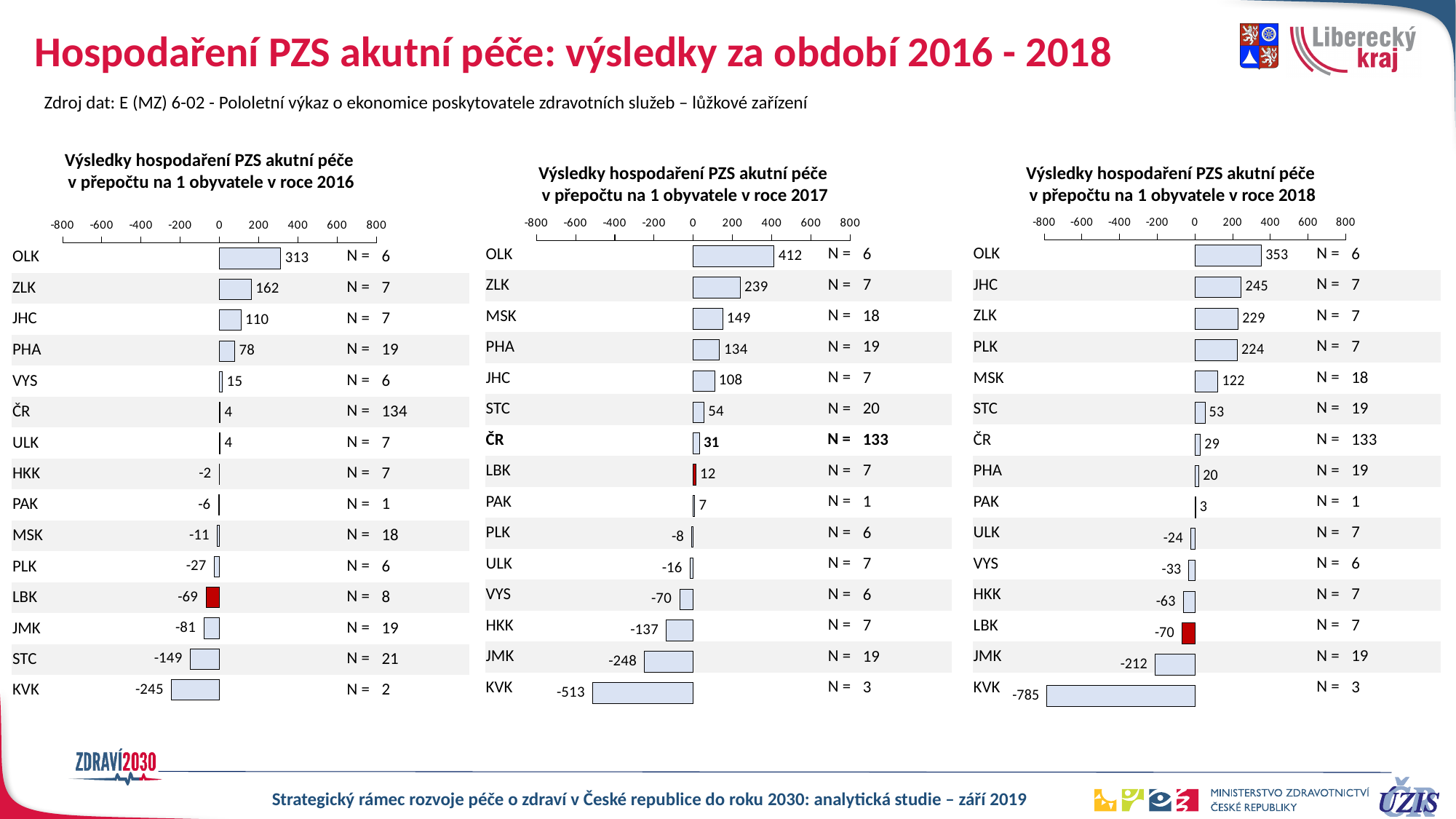
In the 2017 chart, which region has the lowest value? KVK In the 2017 chart, which is larger, the value for MSK or the value for PHA? MSK In the 2018 chart, what is the value for ČR? 29 In the 2018 chart, what is the value for KVK? -785 In the 2018 chart, which region has the highest value? OLK In the 2017 chart, what is the value for LBK? 12 In the 2016 chart, what is the difference between the values for OLK and ZLK? 151 In the 2016 chart, what is the value for OLK? 313 In the 2018 chart, is the value for JMK greater or less than -200? less How many regions are listed in the 2016 chart? 15 What kind of chart is the 2017 chart? bar chart In the 2016 chart, which region's bar is coloured red? LBK